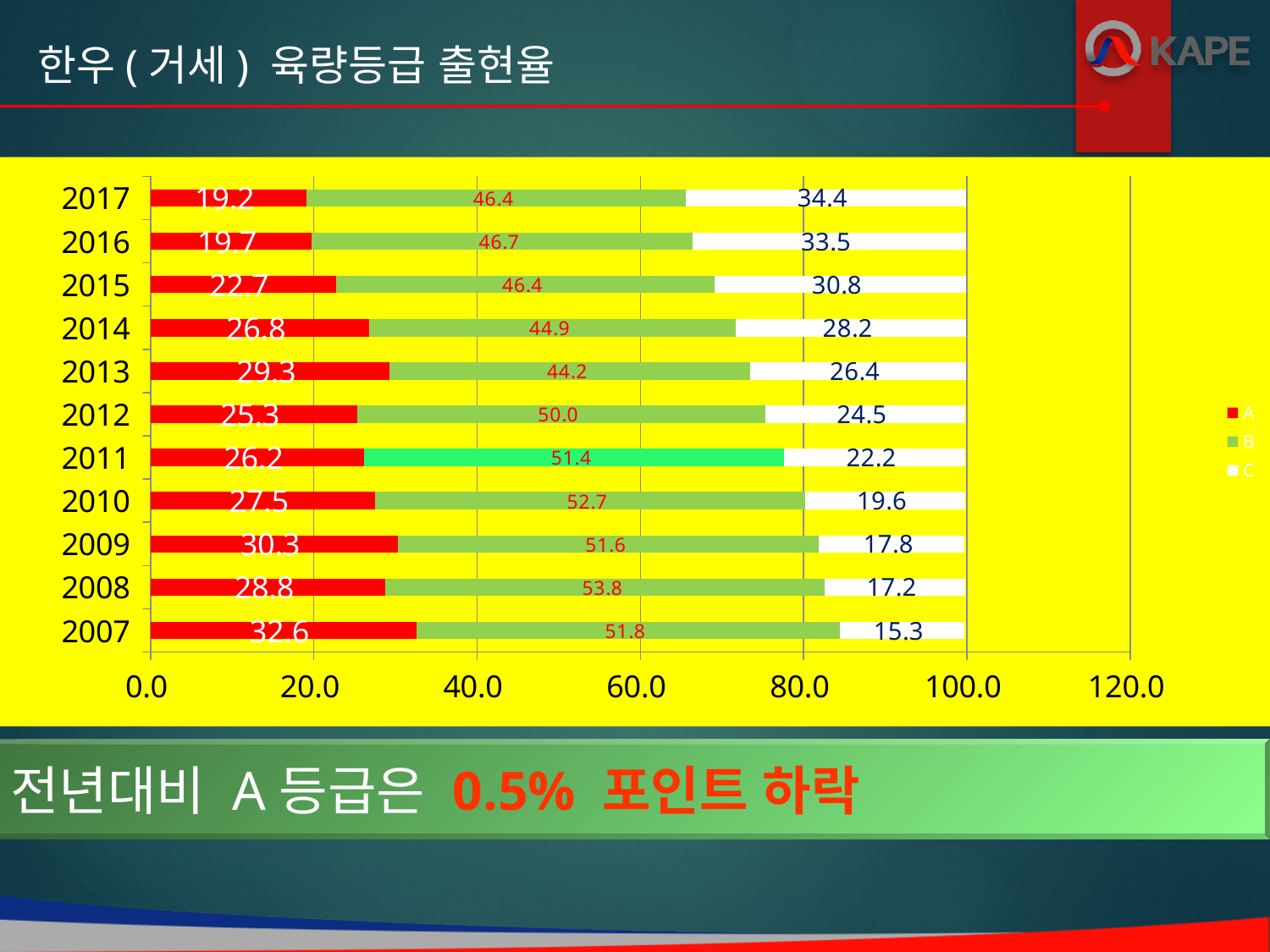
What is the difference between the series A values for 2016 and 2017? 0.5 What is the value of series B for 2011? 51.4 How many years are shown on the chart? 11 Which year has the lowest value for series C? 2007 How many series does the legend list? 3 What is the value of series A for 2017? 19.2 What is the value of series C for 2007? 15.3 Which year has the highest value for series A? 2007 Which is larger, the series C value for 2017 or for 2016? 2017 What is the total of the stacked bar for 2017? 100.0 Which year has the highest value for series B? 2008 What kind of chart is shown on the slide? Stacked bar chart